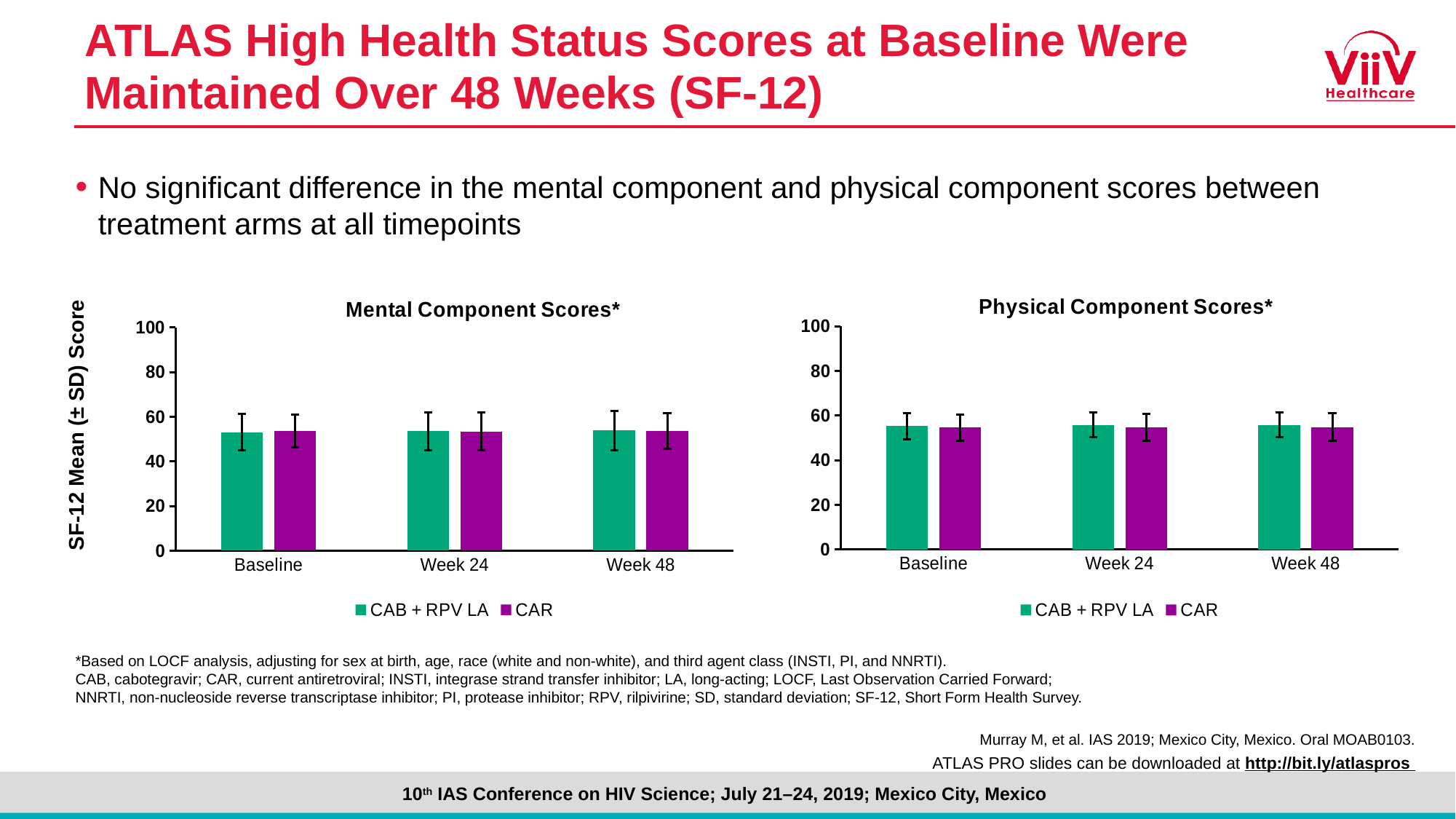
What kind of chart is the Mental Component Scores chart? bar chart What is the maximum value shown on the y axis of the Physical Component Scores chart? 100 How many timepoint categories are shown on the x axis of the Mental Component Scores chart? 3 In the Mental Component Scores chart, is the value for CAB + RPV LA at Baseline greater or less than 40? greater In the Physical Component Scores chart, is the value for CAR at Baseline greater or less than 60? less What is the title of the chart on the right side of the slide? Physical Component Scores* What are the two series named in the legend of the Mental Component Scores chart? CAB + RPV LA and CAR In the Mental Component Scores chart, is the value for CAR at Week 24 greater or less than 20? greater How many series does the legend of the Physical Component Scores chart list? 2